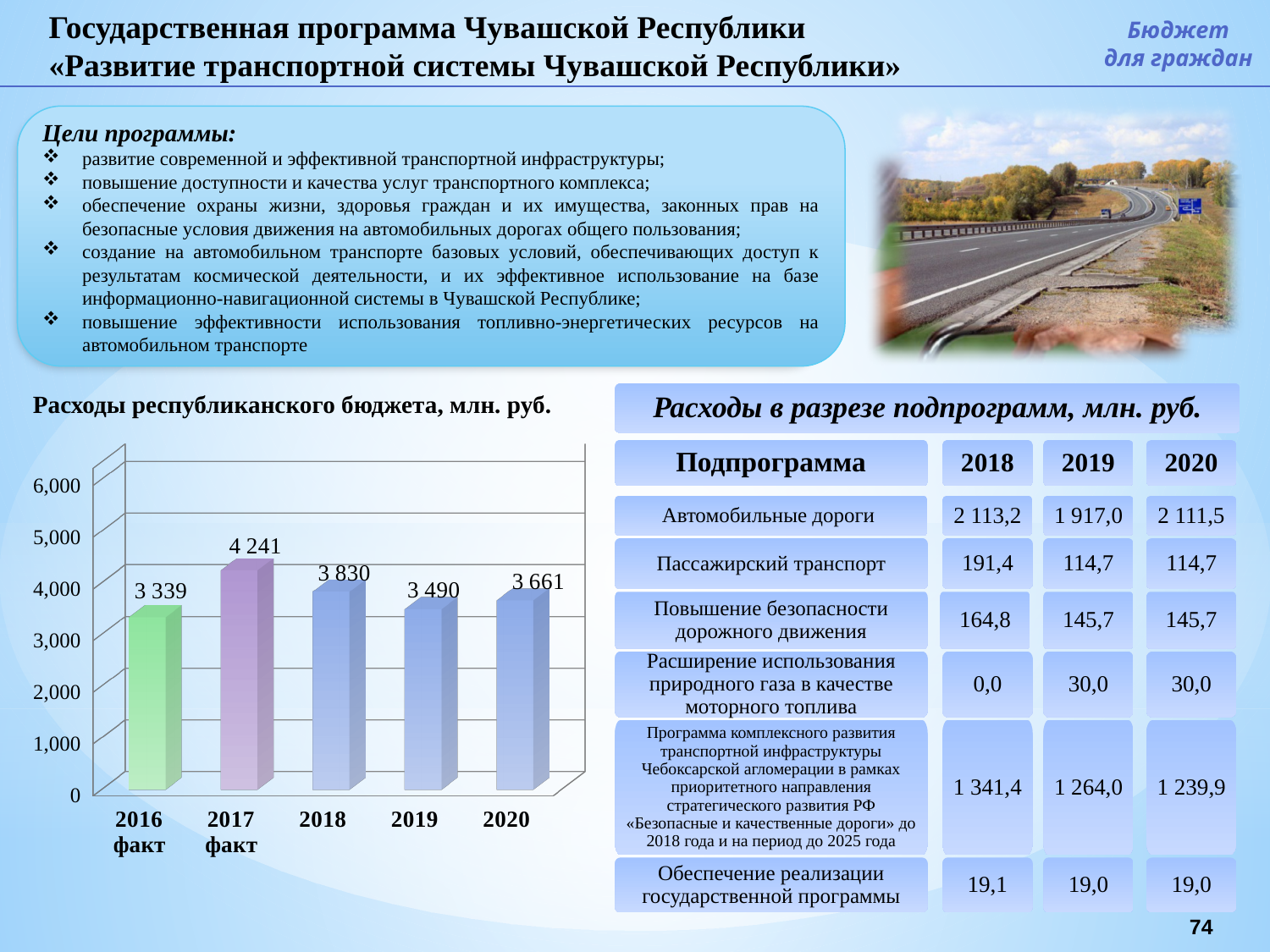
In the chart "Расходы республиканского бюджета, млн. руб.", what is the difference between the values for 2017 факт and 2016 факт? 902 What kind of chart is "Расходы республиканского бюджета, млн. руб."? bar chart In the chart "Расходы республиканского бюджета, млн. руб.", what is the difference between the values for 2018 and 2019? 340 What is the value for 2016 факт in the chart "Расходы республиканского бюджета, млн. руб."? 3 339 How many bars are shown in the chart "Расходы республиканского бюджета, млн. руб."? 5 What is the value for 2018 in the chart "Расходы республиканского бюджета, млн. руб."? 3 830 In the chart "Расходы республиканского бюджета, млн. руб.", which is larger: the value for 2019 or the value for 2020? 2020 What is the value for 2020 in the chart "Расходы республиканского бюджета, млн. руб."? 3 661 Which year has the highest value in the chart "Расходы республиканского бюджета, млн. руб."? 2017 факт In the chart "Расходы республиканского бюджета, млн. руб.", do the values rise or fall from 2018 to 2019? fall In the chart "Расходы республиканского бюджета, млн. руб.", is the value for 2017 факт greater or less than 4,000? greater Which year has the lowest value in the chart "Расходы республиканского бюджета, млн. руб."? 2016 факт